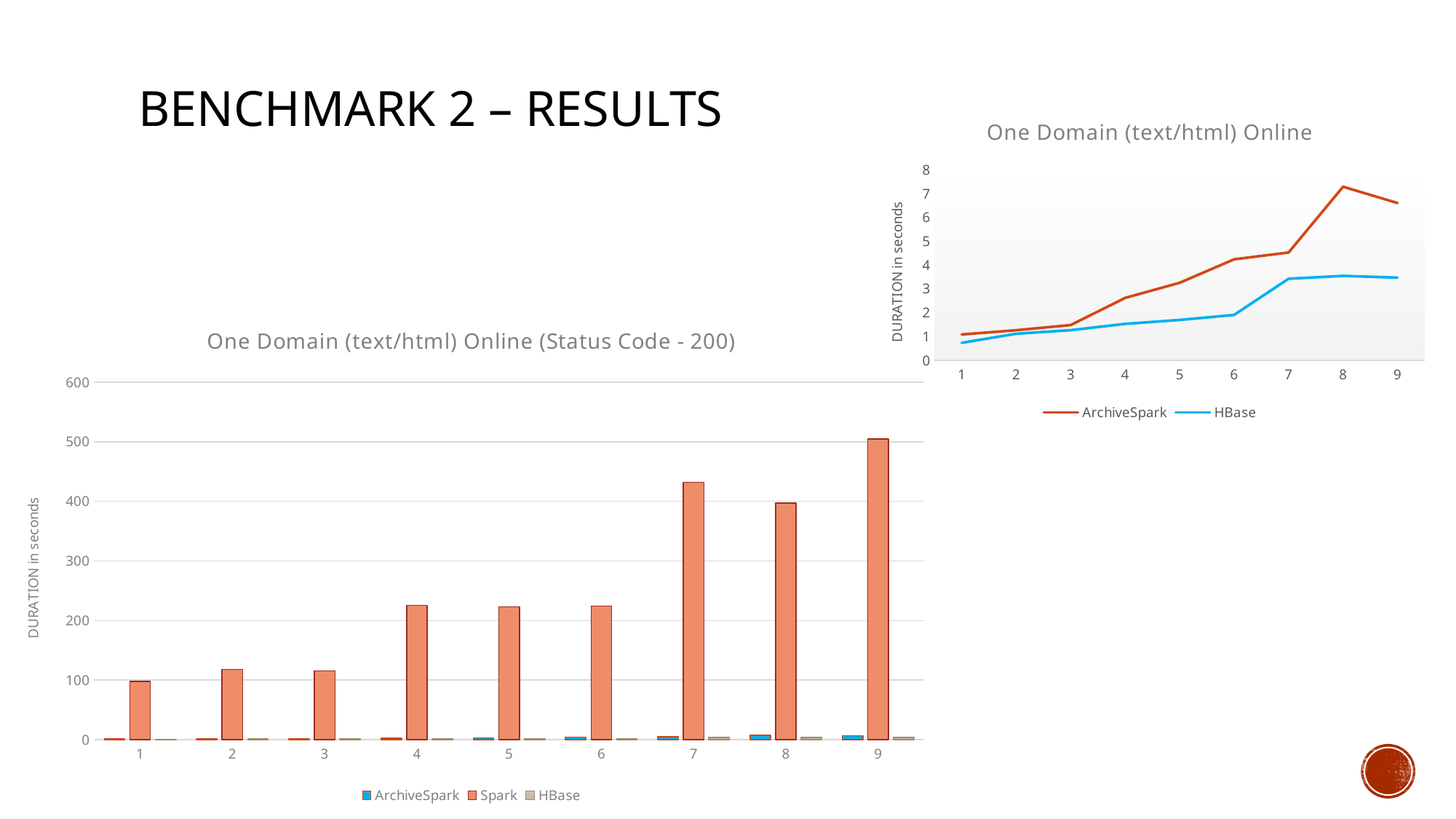
In the line chart "One Domain (text/html) Online", at which category does the ArchiveSpark line reach its highest value? 8 In the line chart "One Domain (text/html) Online", is the HBase value at category 9 greater or less than 3? greater In the bar chart "One Domain (text/html) Online (Status Code - 200)", at which category is the Spark bar lowest? 1 In the bar chart "One Domain (text/html) Online (Status Code - 200)", is the Spark value for category 4 greater or less than 200? greater In the line chart "One Domain (text/html) Online", which series has the higher value at category 7, ArchiveSpark or HBase? ArchiveSpark In the bar chart "One Domain (text/html) Online (Status Code - 200)", at which category is the Spark bar highest? 9 In the line chart "One Domain (text/html) Online", how many series does the legend list? 2 In the bar chart "One Domain (text/html) Online (Status Code - 200)", how many series does the legend list? 3 In the chart titled "One Domain (text/html) Online (Status Code - 200)", what kind of chart is it? bar chart In the bar chart "One Domain (text/html) Online (Status Code - 200)", how many categories are shown on the x axis? 9 In the bar chart "One Domain (text/html) Online (Status Code - 200)", is the Spark value for category 7 greater or less than 400? greater In the chart titled "One Domain (text/html) Online" on the right, what kind of chart is it? line chart